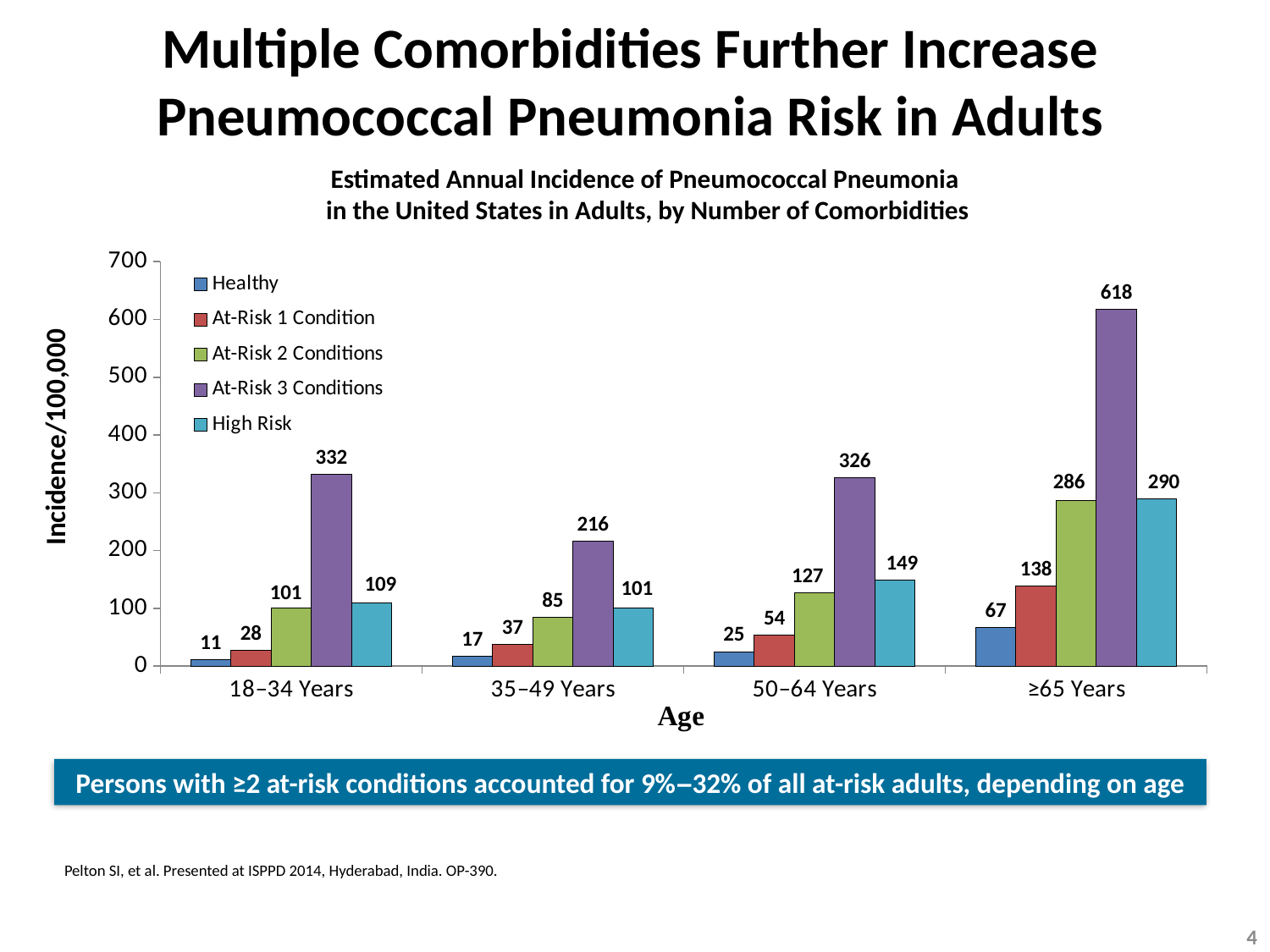
What is the difference between the At-Risk 3 Conditions and High Risk values in the ≥65 Years group? 328 Which is larger in the 50–64 Years group: At-Risk 2 Conditions or High Risk? High Risk What is the label of the y axis? Incidence/100,000 What kind of chart is shown on the slide? Bar chart How many series does the legend list? 5 Does the incidence for At-Risk 1 Condition rise or fall as age increases along the x axis? Rise What is the incidence per 100,000 for At-Risk 3 Conditions in the ≥65 Years group? 618 Which series has the lowest incidence in the 35–49 Years group? Healthy What is the incidence per 100,000 for High Risk adults aged 50–64 Years? 149 What is the incidence per 100,000 for Healthy adults aged 18–34 Years? 11 How many age groups are shown on the x axis? 4 Which age group has the highest incidence for At-Risk 3 Conditions? ≥65 Years